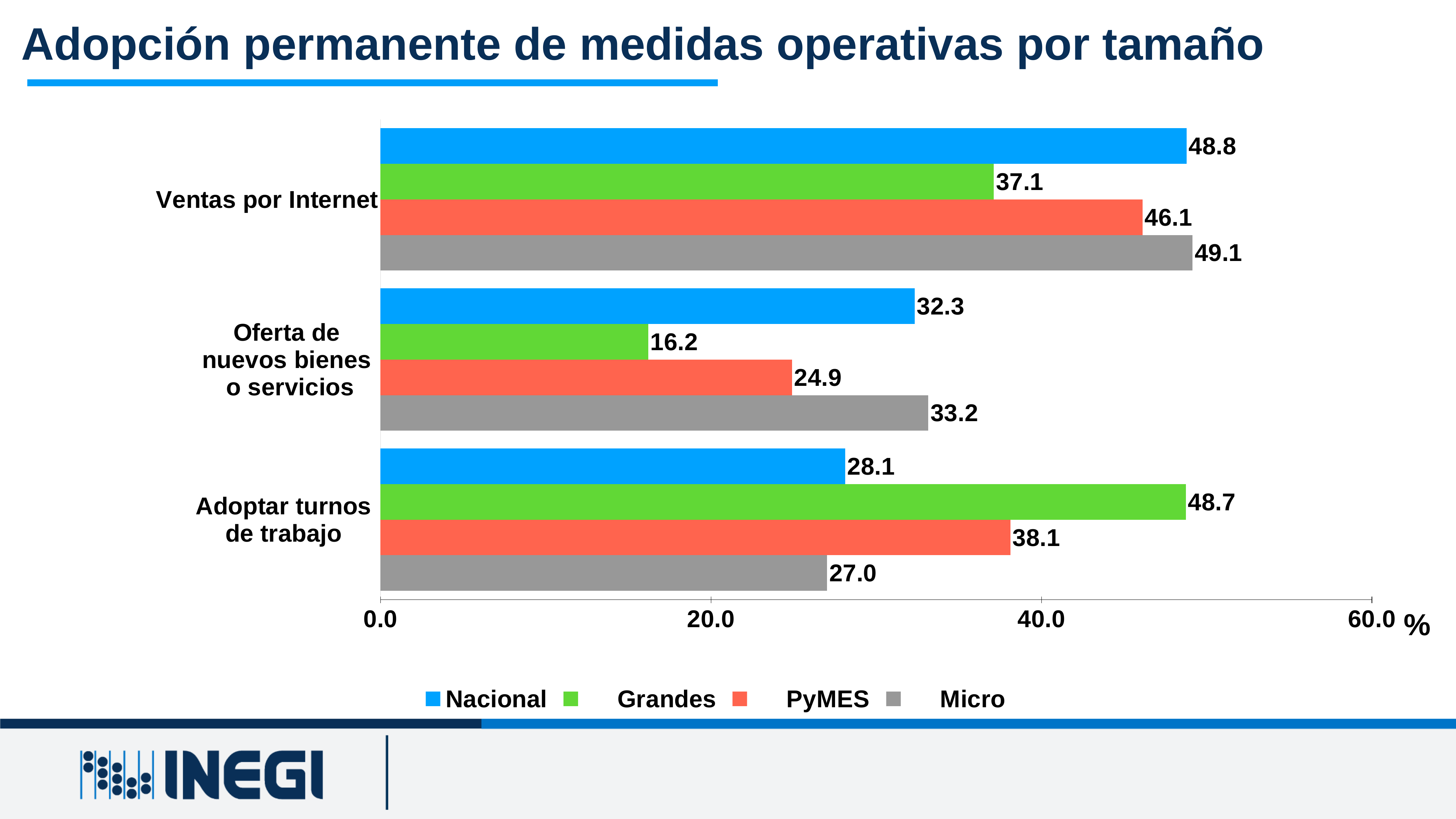
How many categories are shown on the y axis? 3 What is the Nacional value for Ventas por Internet? 48.8 Is the PyMES value for Oferta de nuevos bienes o servicios greater or less than 20.0? greater How many series does the legend list? 4 What is the PyMES value for Adoptar turnos de trabajo? 38.1 What is the difference between the Nacional and Grandes values for Ventas por Internet? 11.7 What is the Grandes value for Oferta de nuevos bienes o servicios? 16.2 For Adoptar turnos de trabajo, which is larger: the Grandes value or the Nacional value? Grandes What is the Micro value for Ventas por Internet? 49.1 Which category has the lowest Micro value? Adoptar turnos de trabajo What kind of chart is shown on the slide? Bar chart Which category has the highest Grandes value? Adoptar turnos de trabajo